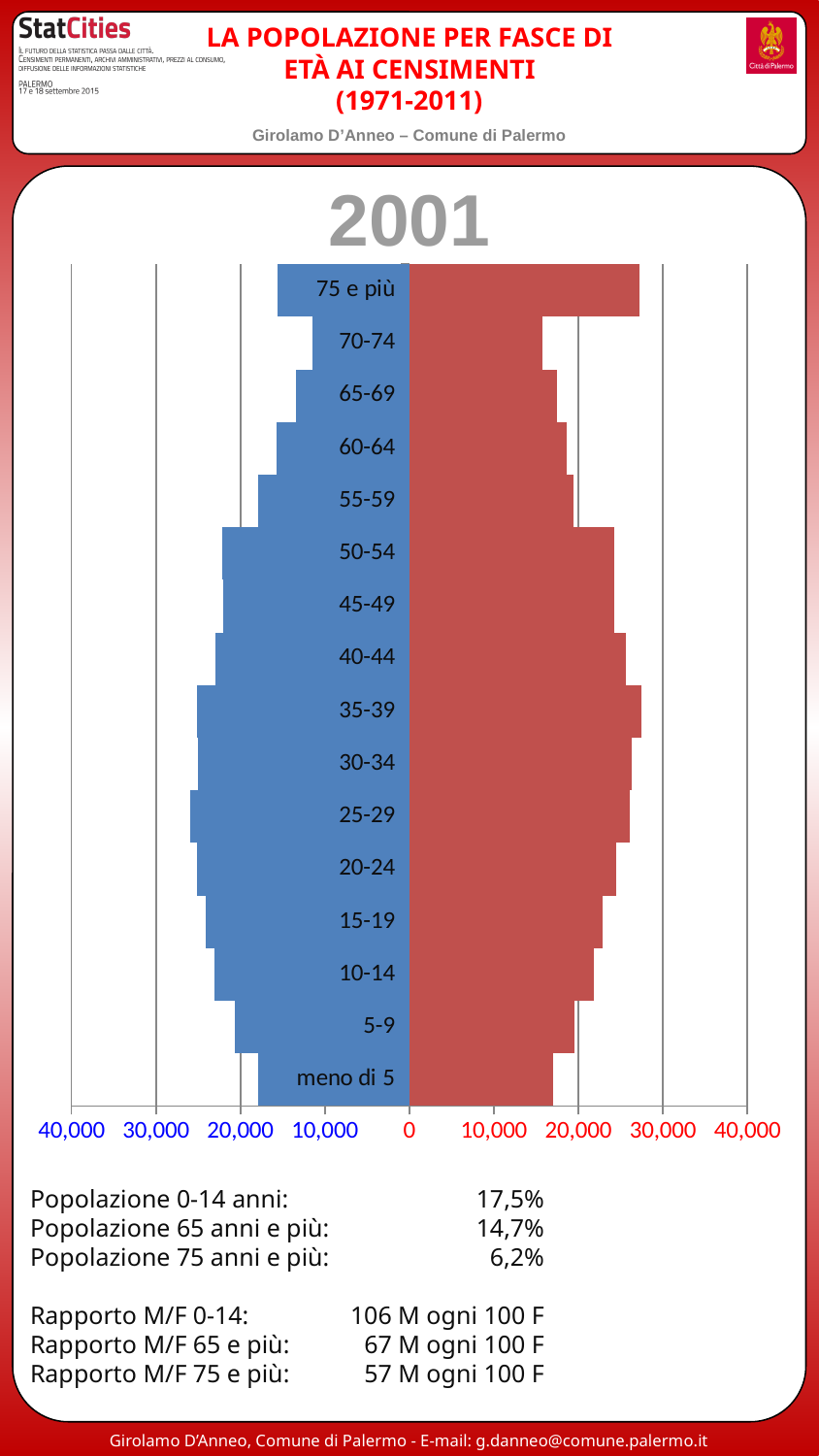
Is the blue bar for 75 e più greater or less than 20,000? less Is the red bar for 35-39 greater or less than 20,000? greater Which colour are the bars on the left side of the chart? blue Is the red bar for 75 e più greater or less than 20,000? greater Which age group has the shortest blue bar? 70-74 For the 75 e più age group, which bar is longer, the blue one or the red one? red How many age groups are shown on the chart? 16 What is the title of the chart? 2001 What type of chart is shown on the slide? bar chart